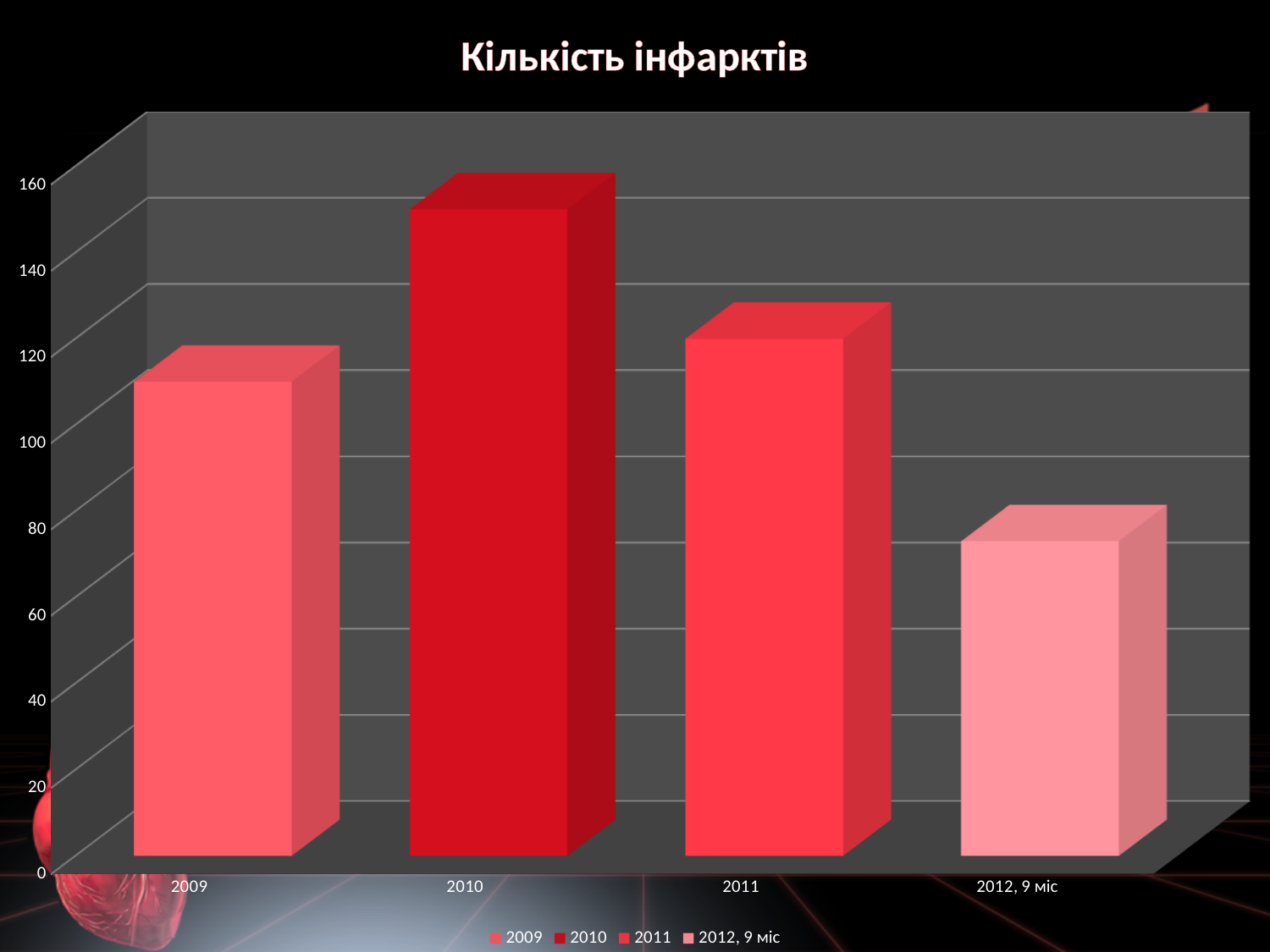
Which category has the lowest bar? 2012, 9 міс How many entries does the legend list? 4 Is the value for 2010 greater or less than 140? greater Do the values rise or fall from 2010 to 2012, 9 міс? fall Which is larger, the value for 2009 or the value for 2011? 2011 What type of chart is shown on the slide? bar chart What is the title of the chart? Кількість інфарктів Is the value for 2009 greater or less than 100? greater How many categories are shown on the x axis? 4 Which is larger, the value for 2010 or the value for 2011? 2010 Is the value for 2012, 9 міс greater or less than 100? less Which category has the highest bar? 2010